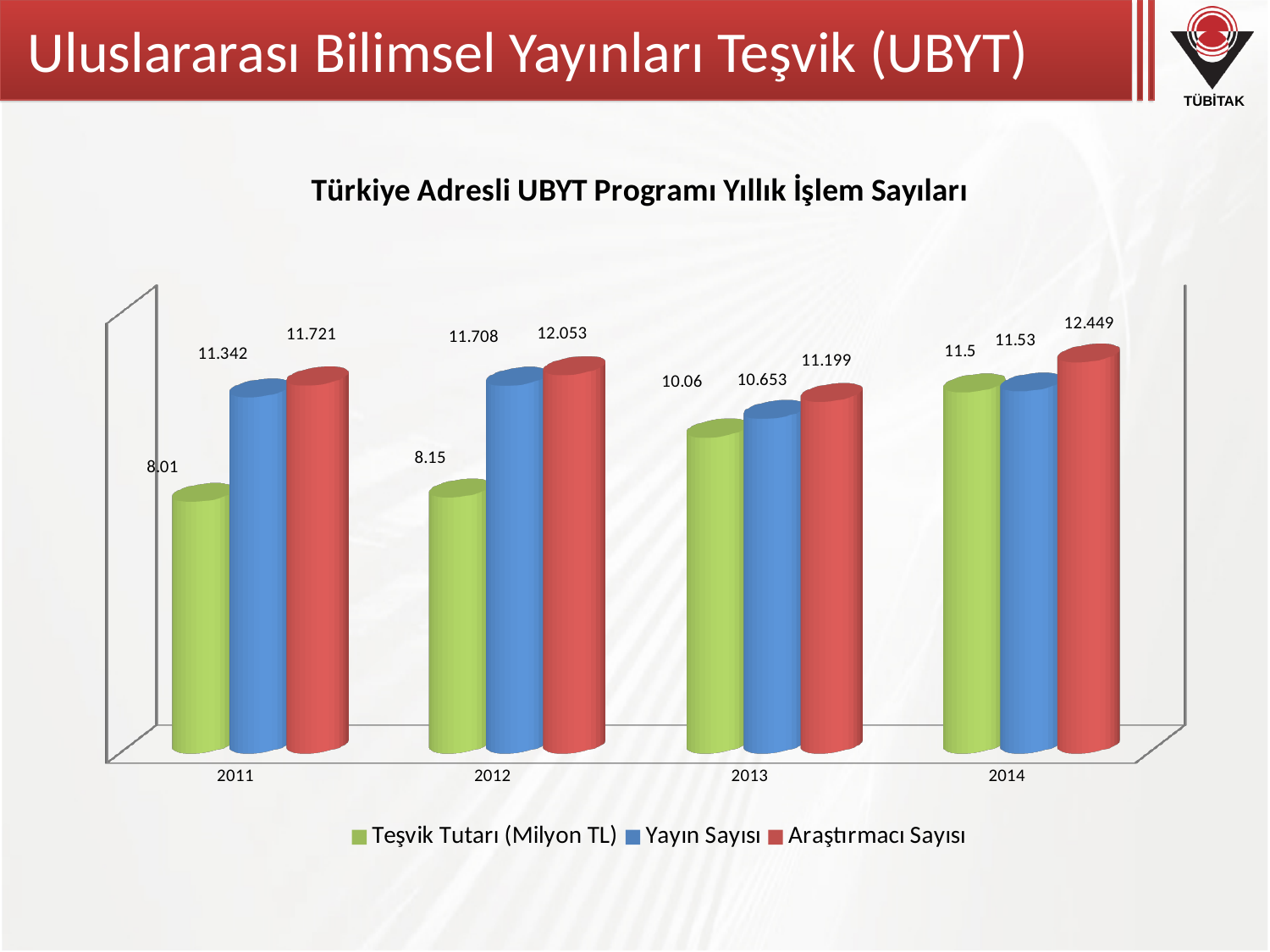
In which year is Araştırmacı Sayısı highest? 2014 What is the value of Teşvik Tutarı (Milyon TL) for 2011? 8.01 In which year is Yayın Sayısı highest? 2012 In 2013, which is larger: Yayın Sayısı or Araştırmacı Sayısı? Araştırmacı Sayısı How many years are shown on the x axis? 4 How many series does the legend list? 3 What is the difference between Teşvik Tutarı (Milyon TL) in 2014 and in 2011? 3.49 What is the value of Yayın Sayısı for 2013? 10.653 What kind of chart is shown? Bar chart Does Teşvik Tutarı (Milyon TL) rise or fall from 2011 to 2014? Rise In which year is Teşvik Tutarı (Milyon TL) lowest? 2011 What is the value of Araştırmacı Sayısı for 2014? 12.449